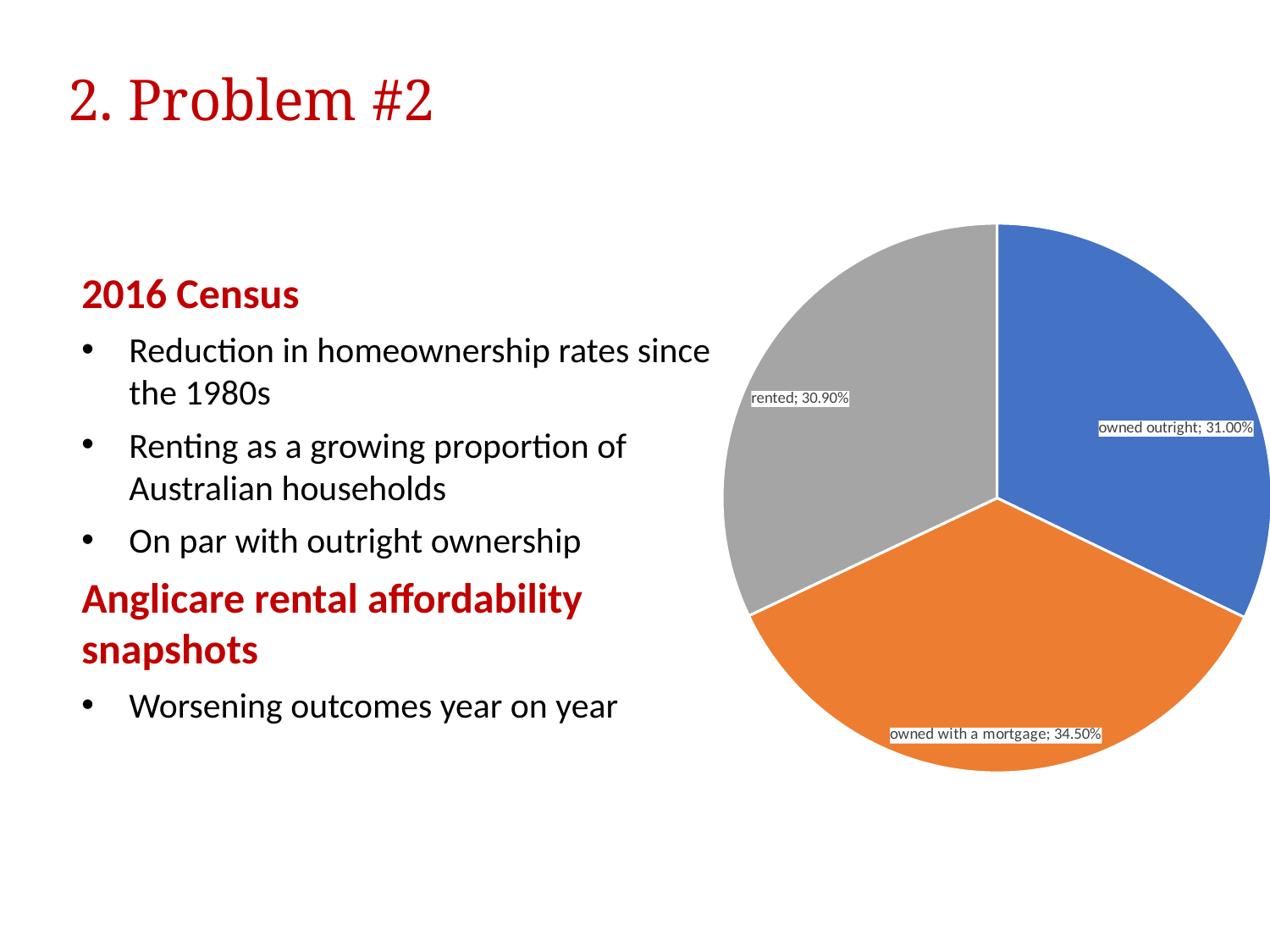
What is the difference between the 'owned with a mortgage' and 'owned outright' values? 3.50% What is the value for the 'rented' slice? 30.90% What is the value for the 'owned outright' slice? 31.00% What is the value for the 'owned with a mortgage' slice? 34.50% What is the difference between the 'owned outright' and 'rented' values? 0.10% What colour is the 'rented' slice? grey What colour is the 'owned with a mortgage' slice? orange Which is larger, the 'owned with a mortgage' slice or the 'rented' slice? owned with a mortgage Which slice of the pie chart is the largest? owned with a mortgage How many slices does the pie chart have? 3 What kind of chart is shown on the slide? pie chart